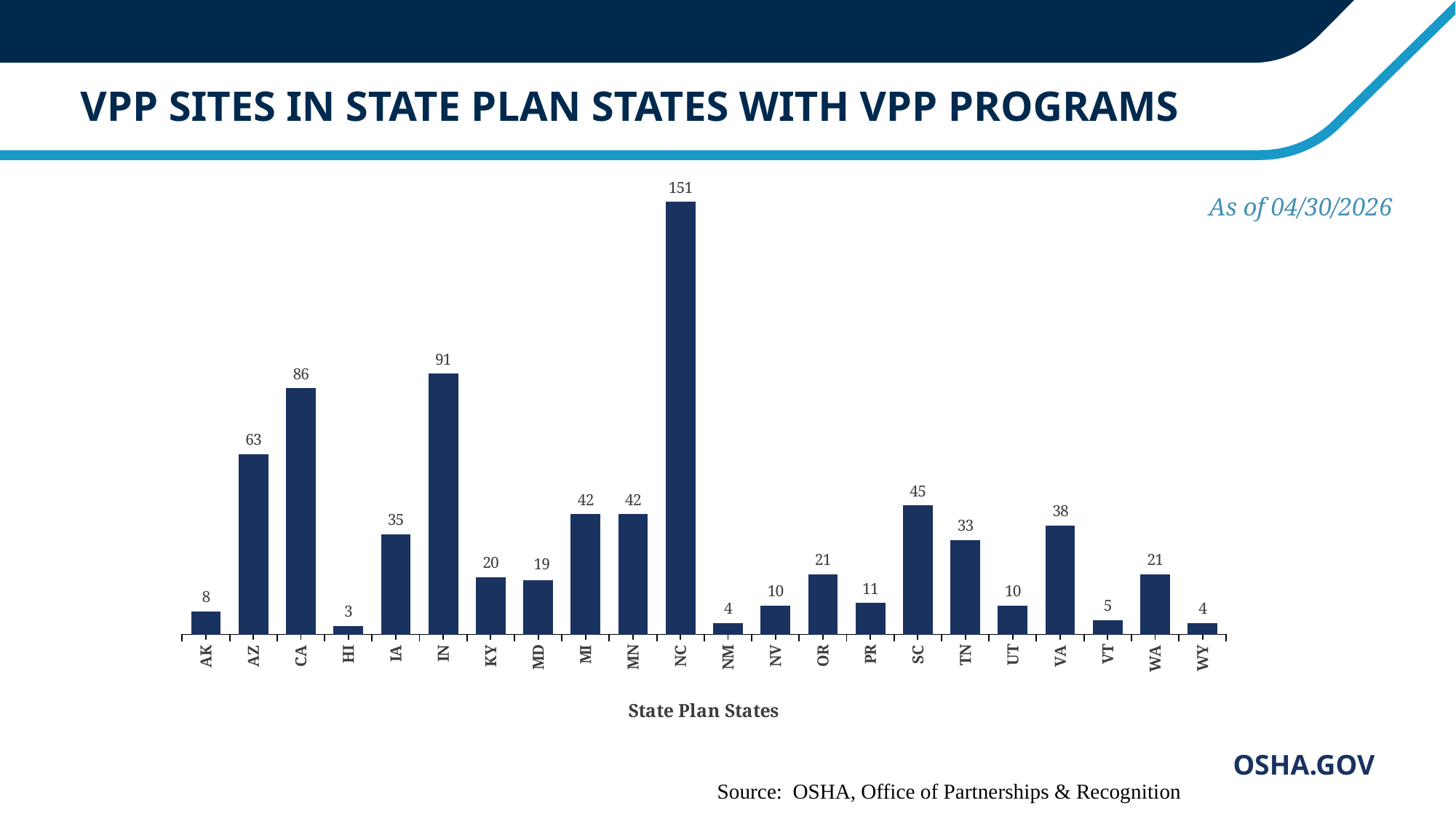
How many VPP sites does the chart show for North Carolina (NC)? 151 What is the difference between the values for NC and IN? 60 Which state has the lowest number of VPP sites? HI What is the difference between the values for CA and AZ? 23 What is the x-axis title of the chart? State Plan States How many states are shown on the x axis of the chart? 22 Which has more VPP sites, VA or TN? VA What is the value shown for South Carolina (SC)? 45 Which state has the highest number of VPP sites? NC What is the value shown for Indiana (IN)? 91 What type of chart is used on this slide? Bar chart Which has more VPP sites, IA or KY? IA